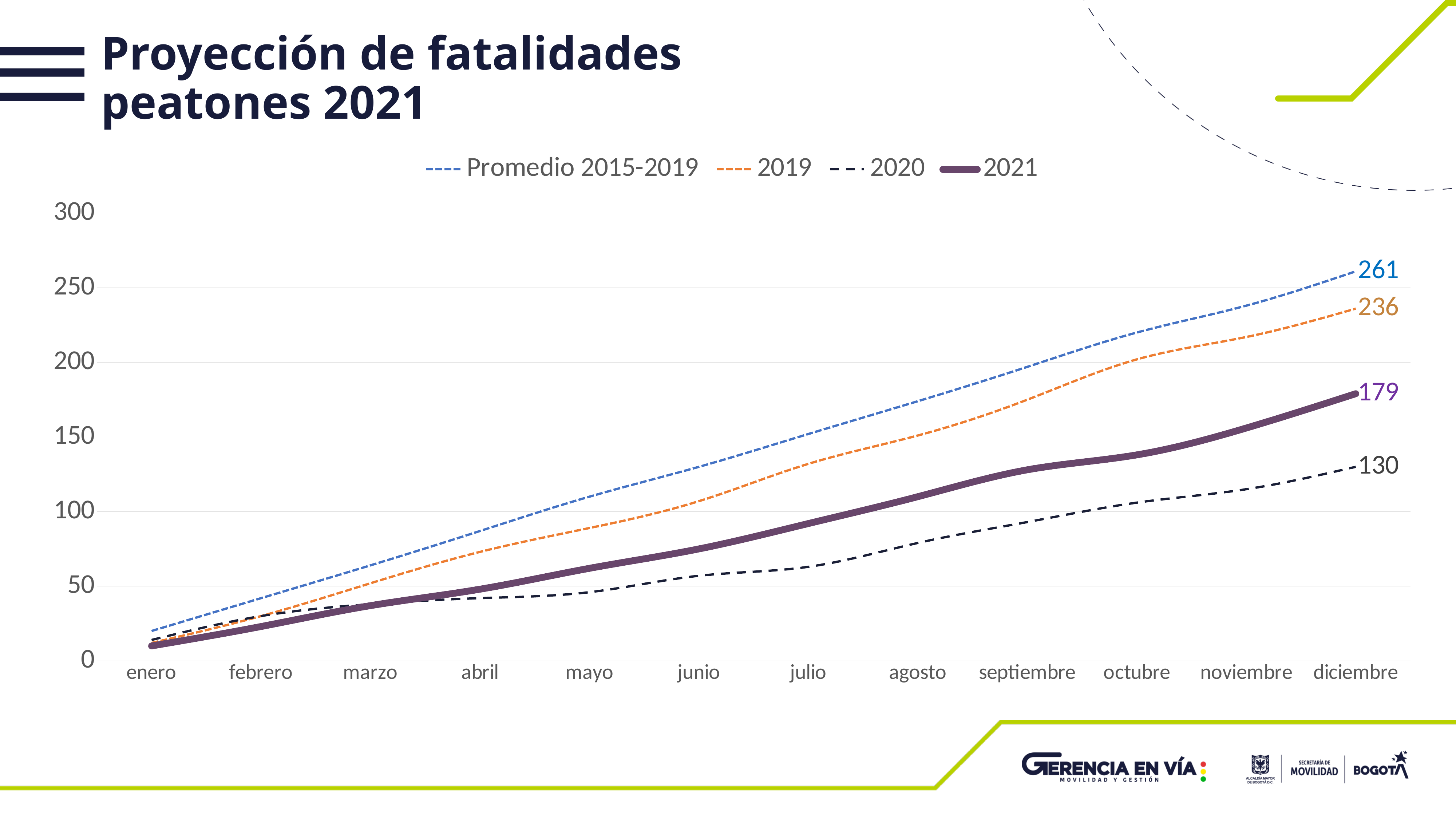
Which series has the lowest value in diciembre? 2020 What is the value for 2020 in diciembre? 130 What is the difference between the diciembre values for Promedio 2015-2019 and 2021? 82 How many series does the legend list? 4 What is the value for 2021 in diciembre? 179 Is the value for 2021 in junio greater or less than 100? less Which series has the highest value in diciembre? Promedio 2015-2019 Do the values for the 2021 series rise or fall from enero to diciembre? rise What type of chart is shown on the slide? line chart What is the value for 2019 in diciembre? 236 How many months are shown on the x axis? 12 What is the value for Promedio 2015-2019 in diciembre? 261